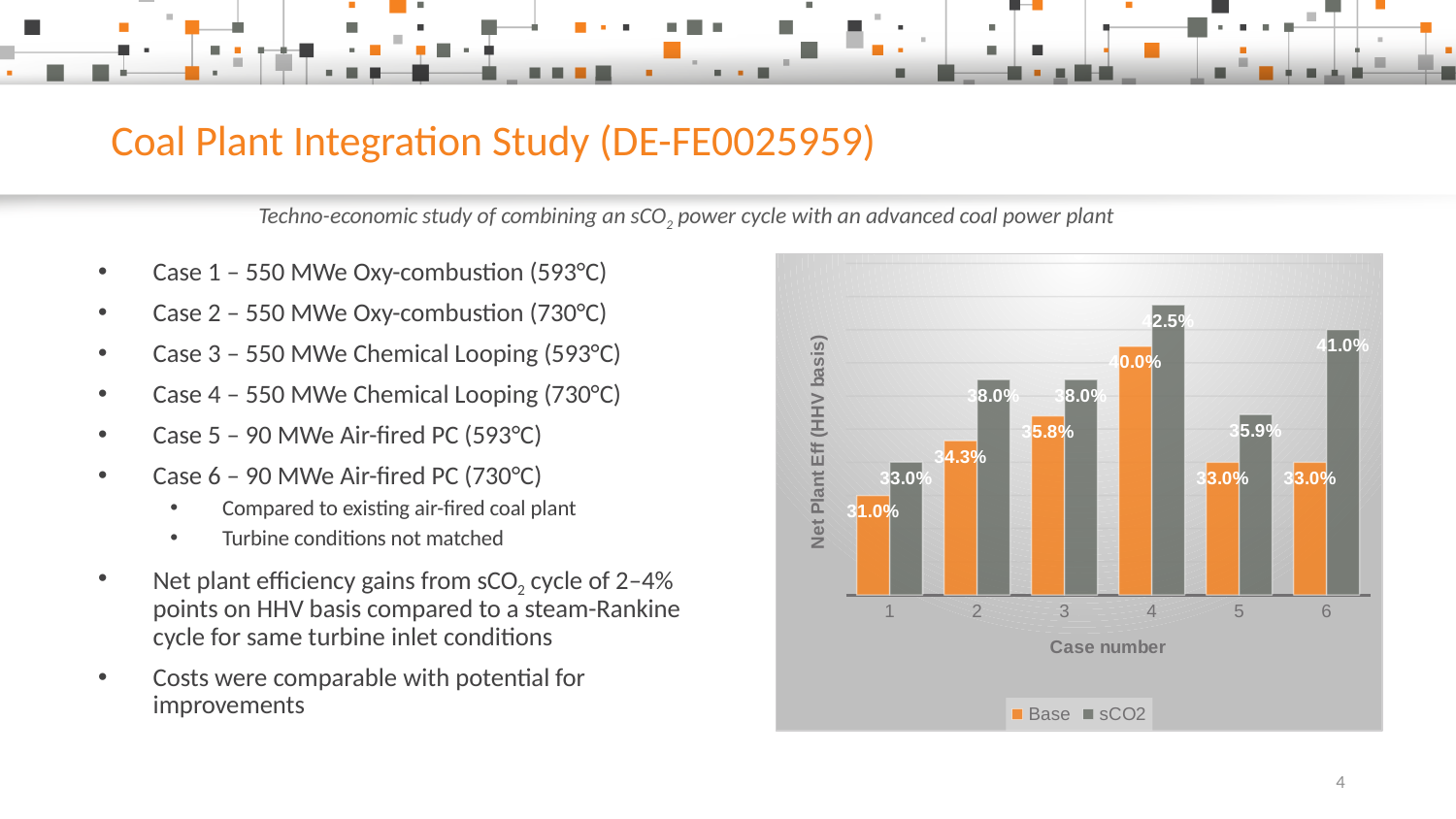
How many case numbers are shown on the x axis of the chart? 6 What is the sCO2 net plant efficiency for case 6? 41.0% Which case number has the lowest Base net plant efficiency? 1 What type of chart is shown on the slide? Bar chart What is the Base net plant efficiency for case 3? 35.8% What is the difference between the sCO2 and Base net plant efficiency for case 2? 3.7% What is the difference between the sCO2 and Base net plant efficiency for case 6? 8.0% How many series does the chart legend list? 2 Which is larger, the sCO2 value for case 5 or the sCO2 value for case 3? sCO2 value for case 3 Which case number has the highest sCO2 net plant efficiency? 4 What is the Base net plant efficiency for case 1? 31.0% What is the label of the y axis of the chart? Net Plant Eff (HHV basis)